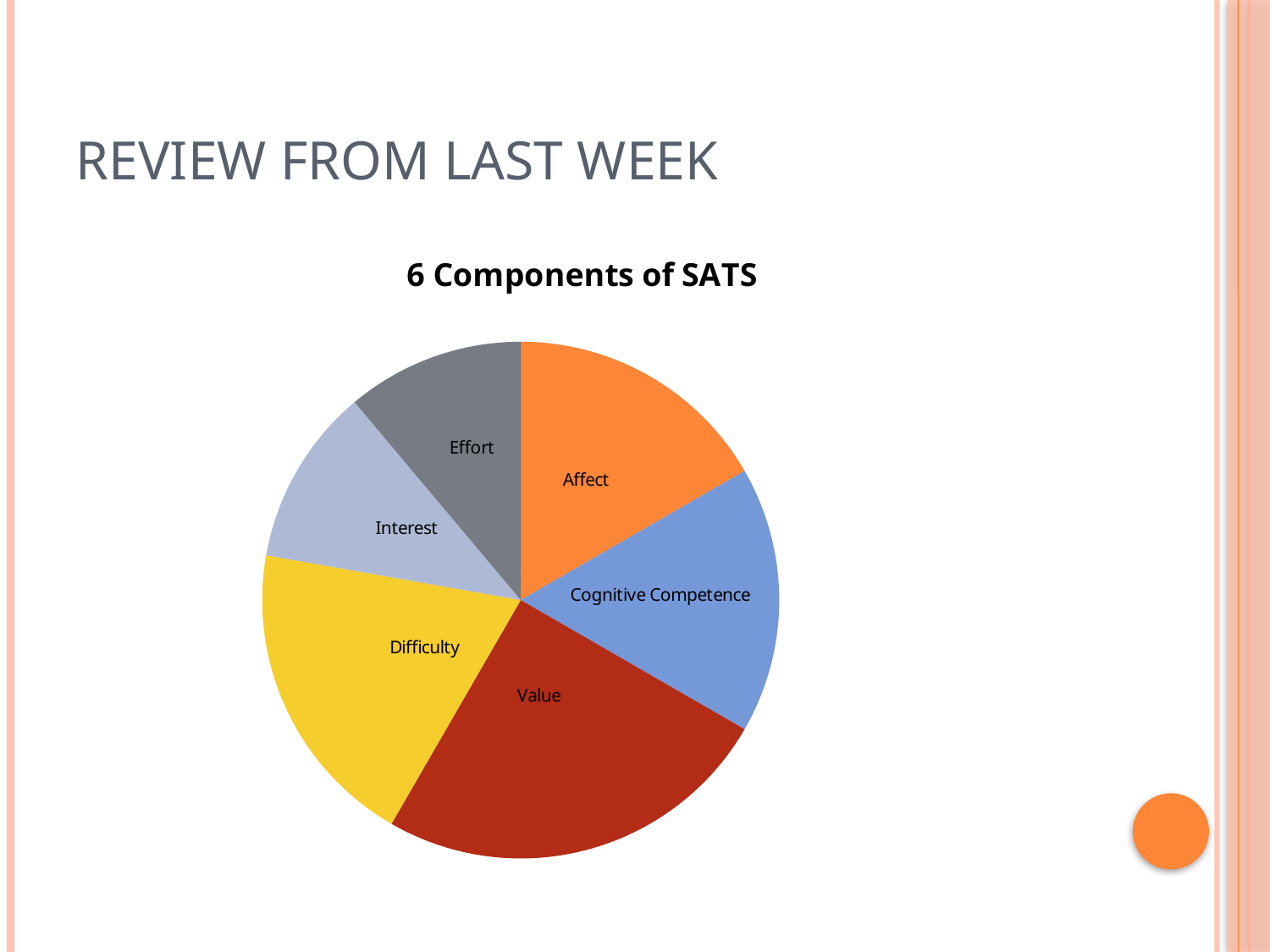
How many slices does the pie chart have? 6 Which slice is larger, Difficulty or Interest? Difficulty Which component has the largest slice of the pie? Value Which component is labelled on the yellow slice? Difficulty What is the title of the pie chart? 6 Components of SATS Which slice is larger, Value or Affect? Value Which slice is larger, Value or Effort? Value What colour is the Value slice of the pie chart? dark red What kind of chart is shown on the slide? pie chart